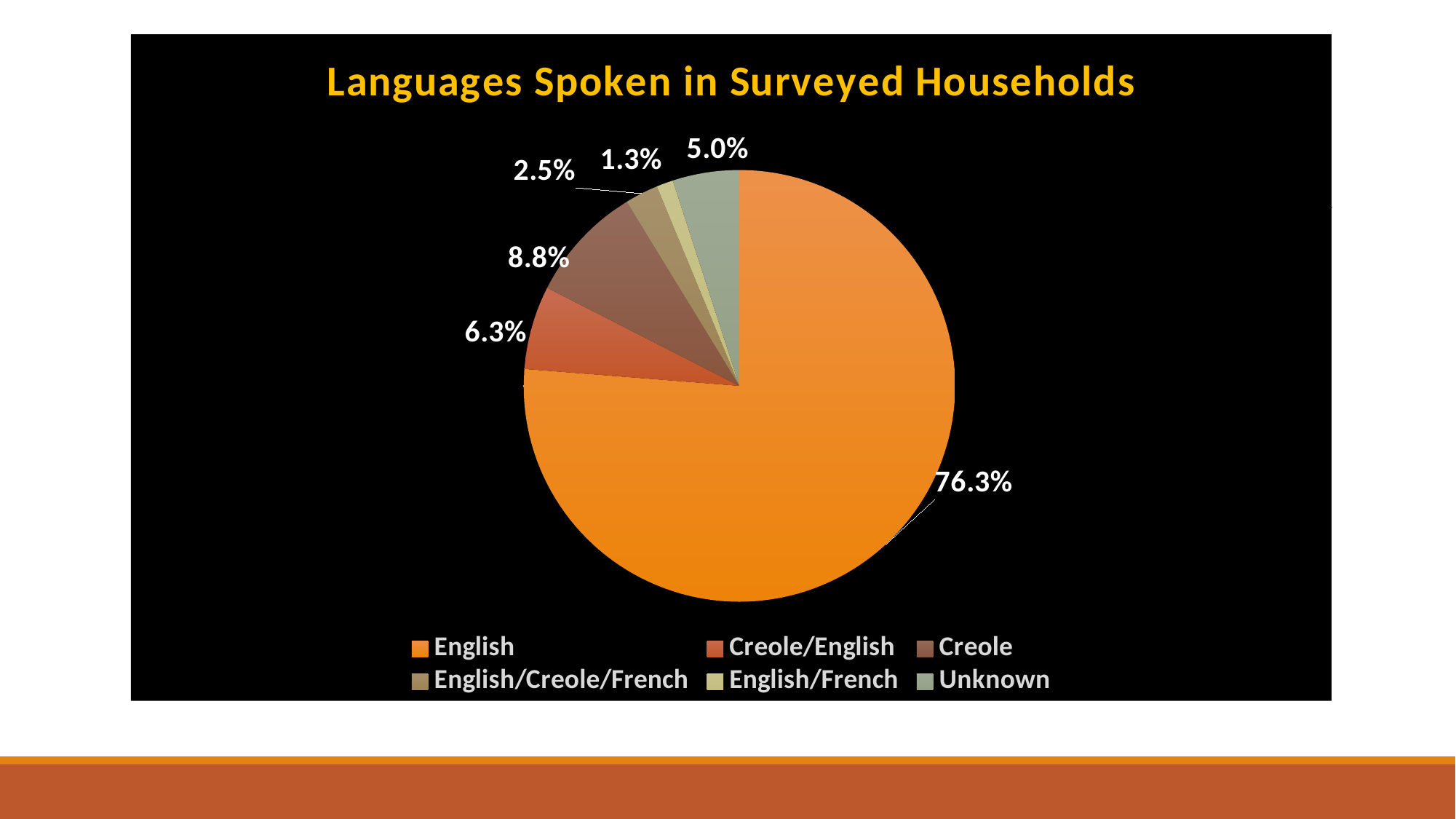
Which language category has the largest share of the pie? English What percentage of surveyed households speak English? 76.3% What is the difference in percentage points between the Creole share and the Unknown share? 3.8 How many language categories are shown in the pie chart? 6 Which language category has the smallest share of the pie? English/French What percentage of surveyed households speak Creole/English? 6.3% What type of chart is shown on the slide? Pie chart What percentage of surveyed households speak English/French? 1.3% What percentage of surveyed households speak Creole? 8.8% What is the title of the chart? Languages Spoken in Surveyed Households What share of the pie is labelled Unknown? 5.0% Which is larger, the share for Creole or the share for Creole/English? Creole